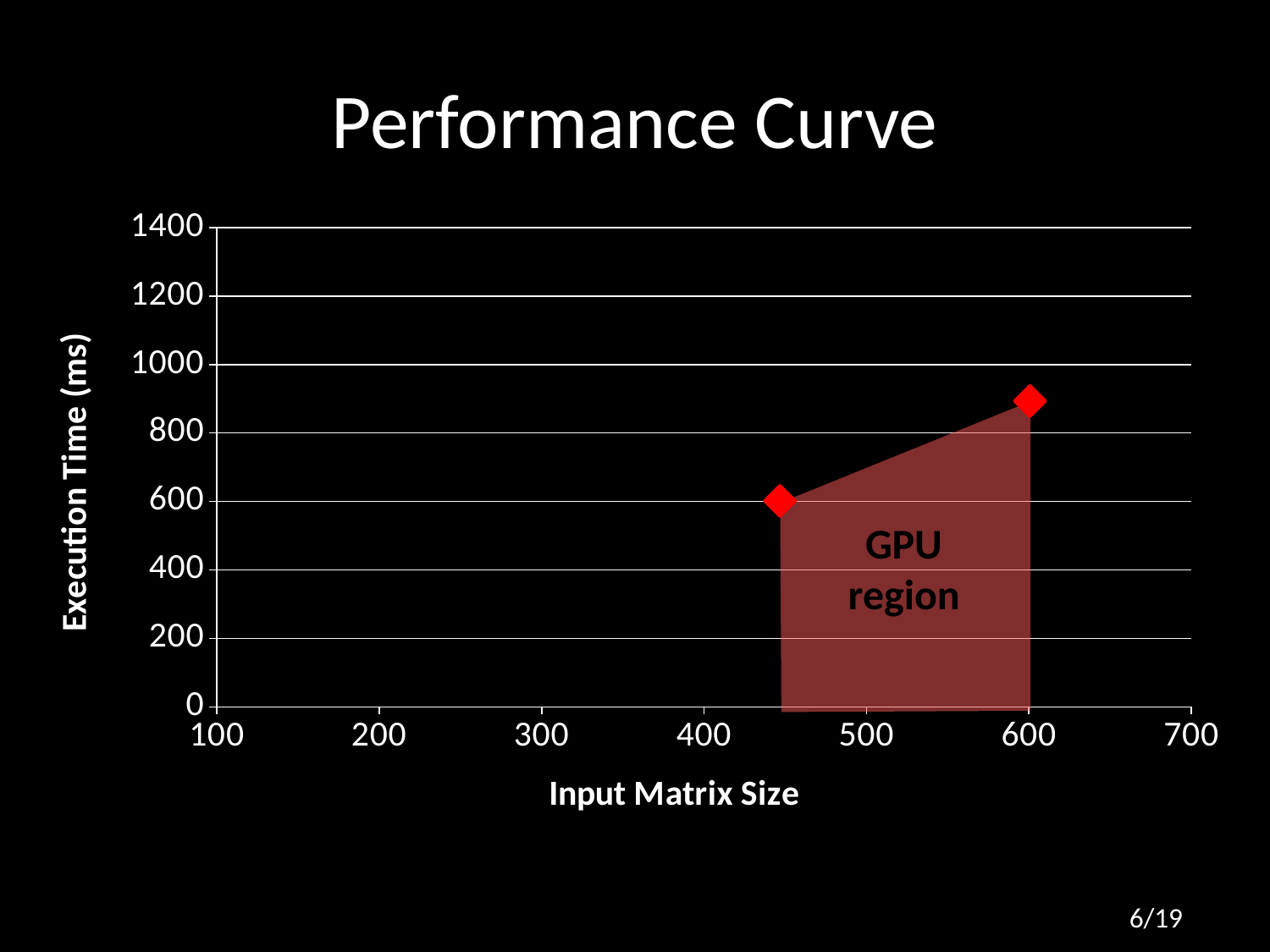
Is the execution time at input matrix size 600 greater or less than 800? greater Does execution time rise or fall as input matrix size increases? rise Is the execution time at input matrix size 600 greater or less than 1000? less Is the execution time of the leftmost data point greater or less than 800? less What kind of chart is shown on the slide? line chart At which input matrix size is the execution time highest? 600 What is the title of the chart? Performance Curve What is the execution time (ms) of the leftmost data point? 600 Which data point has the higher execution time, the one at input matrix size 600 or the leftmost one? the one at 600 What label is written inside the shaded area of the chart? GPU region How many data points are plotted on the chart? 2